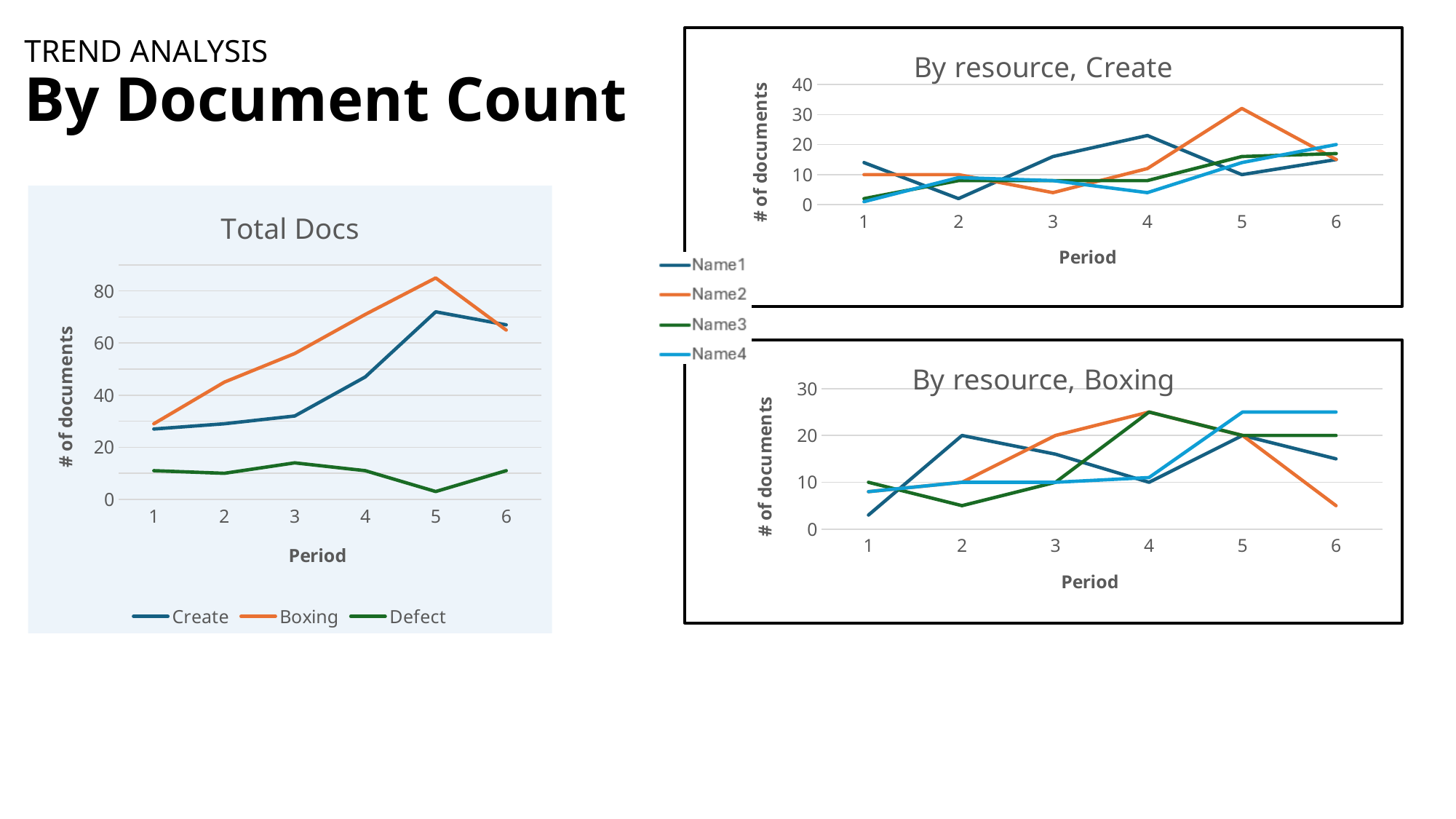
In the By resource, Create chart, at which period does Name2 reach its highest value? 5 In the By resource, Boxing chart, what is the value for Name1 at period 2? 20 What kind of chart is the Total Docs chart? line chart How many periods are plotted on the x axis of the Total Docs chart? 6 In the By resource, Create chart, is the Name1 value at period 2 greater or less than 10? less How many series does the legend of the Total Docs chart list? 3 In the Total Docs chart, which series is higher at period 4, Create or Boxing? Boxing In the Total Docs chart, is the Boxing value at period 5 greater or less than 80? greater In the Total Docs chart, is the Defect value at period 5 greater or less than 10? less How many series does the legend of the By resource, Create chart list? 4 In the Total Docs chart, at which period does the Boxing series reach its highest value? 5